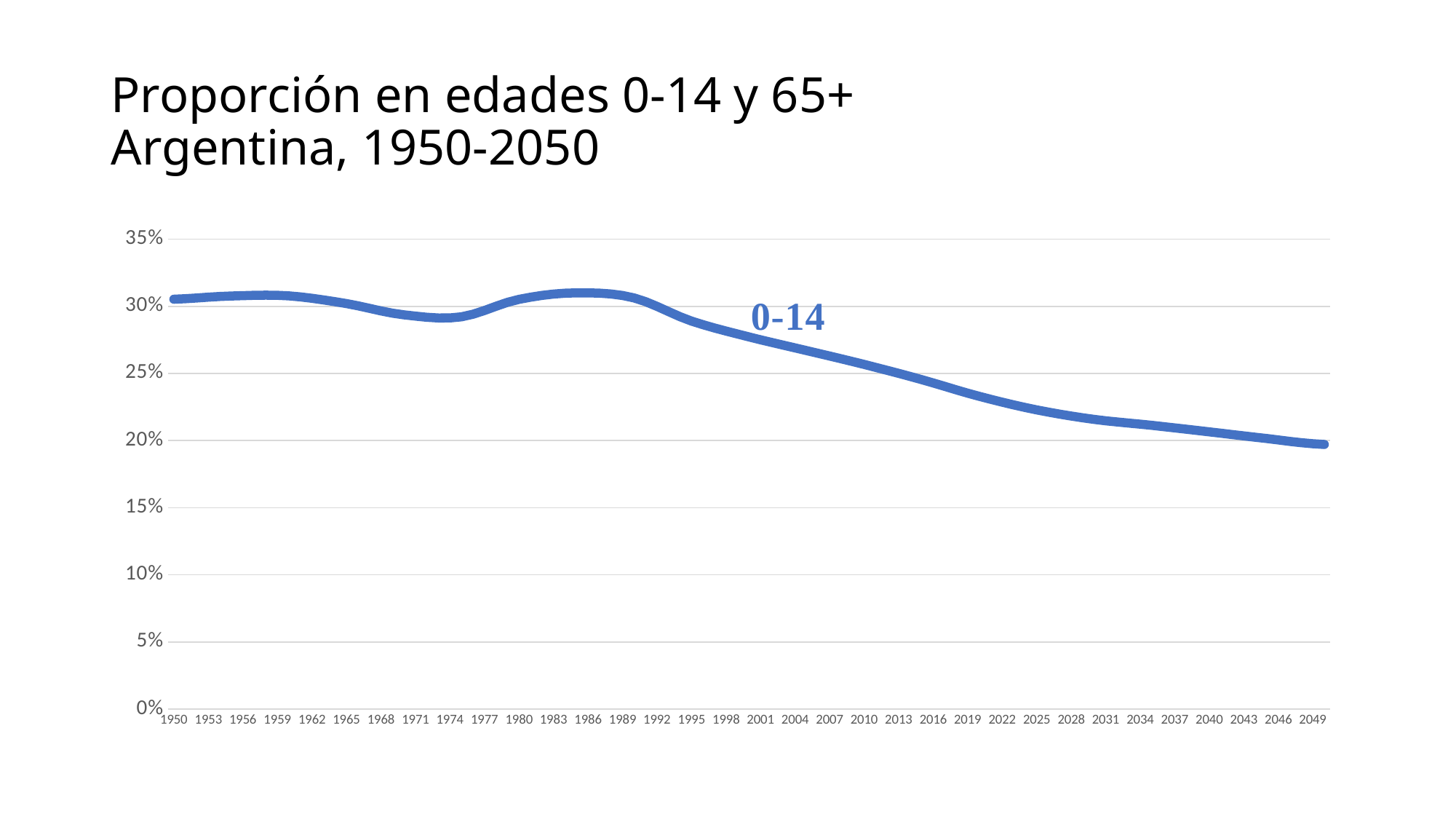
Which year has the lowest value for 0-14 on the chart? 2050 Is the value for 0-14 in 2049 greater or less than 25%? less Is the value for 0-14 in 2013 greater or less than 30%? less What kind of chart is shown on the slide? line chart Which is larger, the 0-14 value in 1950 or in 2049? 1950 What label is printed next to the plotted line? 0-14 Which is larger, the 0-14 value in 1974 or in 2013? 1974 What is the title of the chart on the slide? Proporción en edades 0-14 y 65+ Argentina, 1950-2050 Is the value for 0-14 in 1950 greater or less than 25%? greater Overall, does the 0-14 line rise or fall from 1950 to 2049? fall How many lines are plotted on the chart? 1